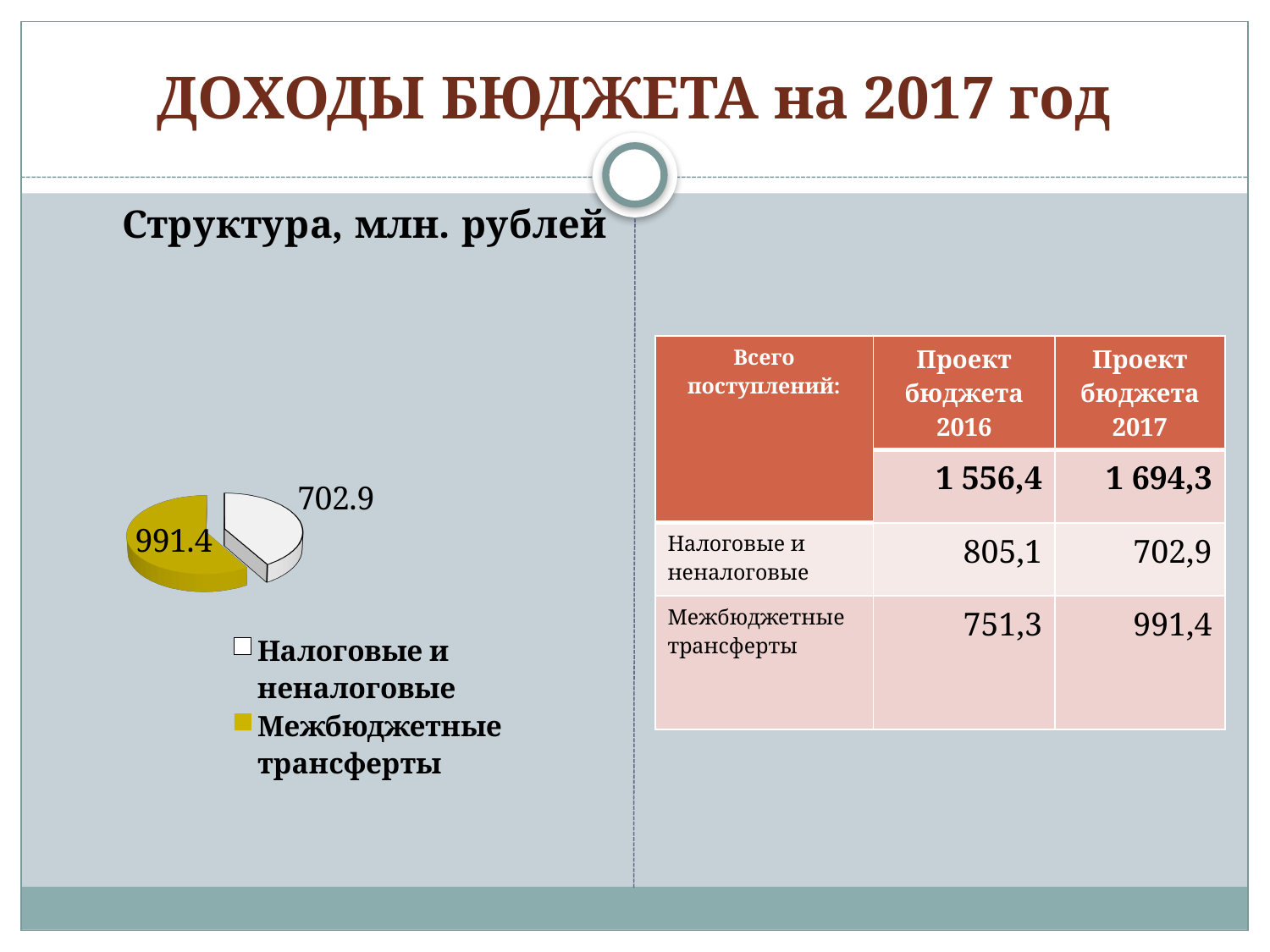
Which is larger in the pie chart: Налоговые и неналоговые or Межбюджетные трансферты? Межбюджетные трансферты Which slice of the pie chart is the largest? Межбюджетные трансферты What is the title of the pie chart? Структура, млн. рублей What is the total of the two slices in the pie chart? 1694.3 Which slice of the pie chart is the smallest? Налоговые и неналоговые What is the value of the Межбюджетные трансферты slice in the pie chart? 991.4 How many entries does the pie chart legend list? 2 What share of the pie does the Межбюджетные трансферты slice represent? 58.5% What type of chart is shown on the slide? Pie chart How many slices does the pie chart have? 2 What is the value of the Налоговые и неналоговые slice in the pie chart? 702.9 What is the difference between the Межбюджетные трансферты and Налоговые и неналоговые values in the pie chart? 288.5